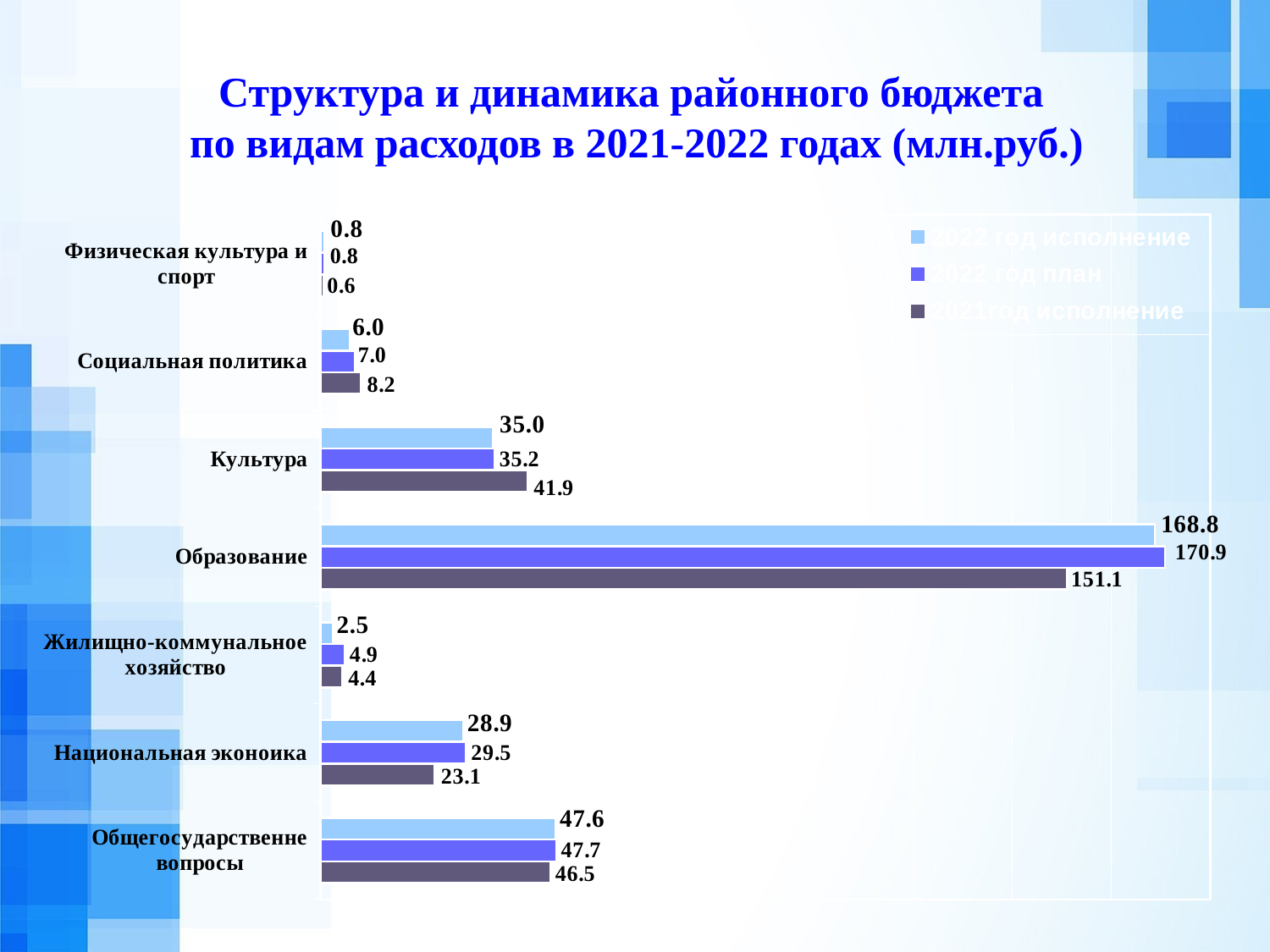
Which category has the highest 2022 год план value? Образование How many series does the legend list? 3 What kind of chart is shown on the slide? Bar chart What is the 2022 год исполнение value for Жилищно-коммунальное хозяйство? 2.5 How many expenditure categories are shown in the chart? 7 What is the 2022 год план value for Национальная экономика? 29.5 What is the difference between the 2022 год план and 2021год исполнение values for Образование? 19.8 What is the difference between the 2022 год план and 2022 год исполнение values for Социальная политика? 1.0 What is the 2022 год исполнение value for Образование? 168.8 What is the 2021год исполнение value for Культура? 41.9 Which category has the lowest 2021год исполнение value? Физическая культура и спорт Which is larger for Социальная политика: the 2022 год исполнение value or the 2021год исполнение value? 2021год исполнение